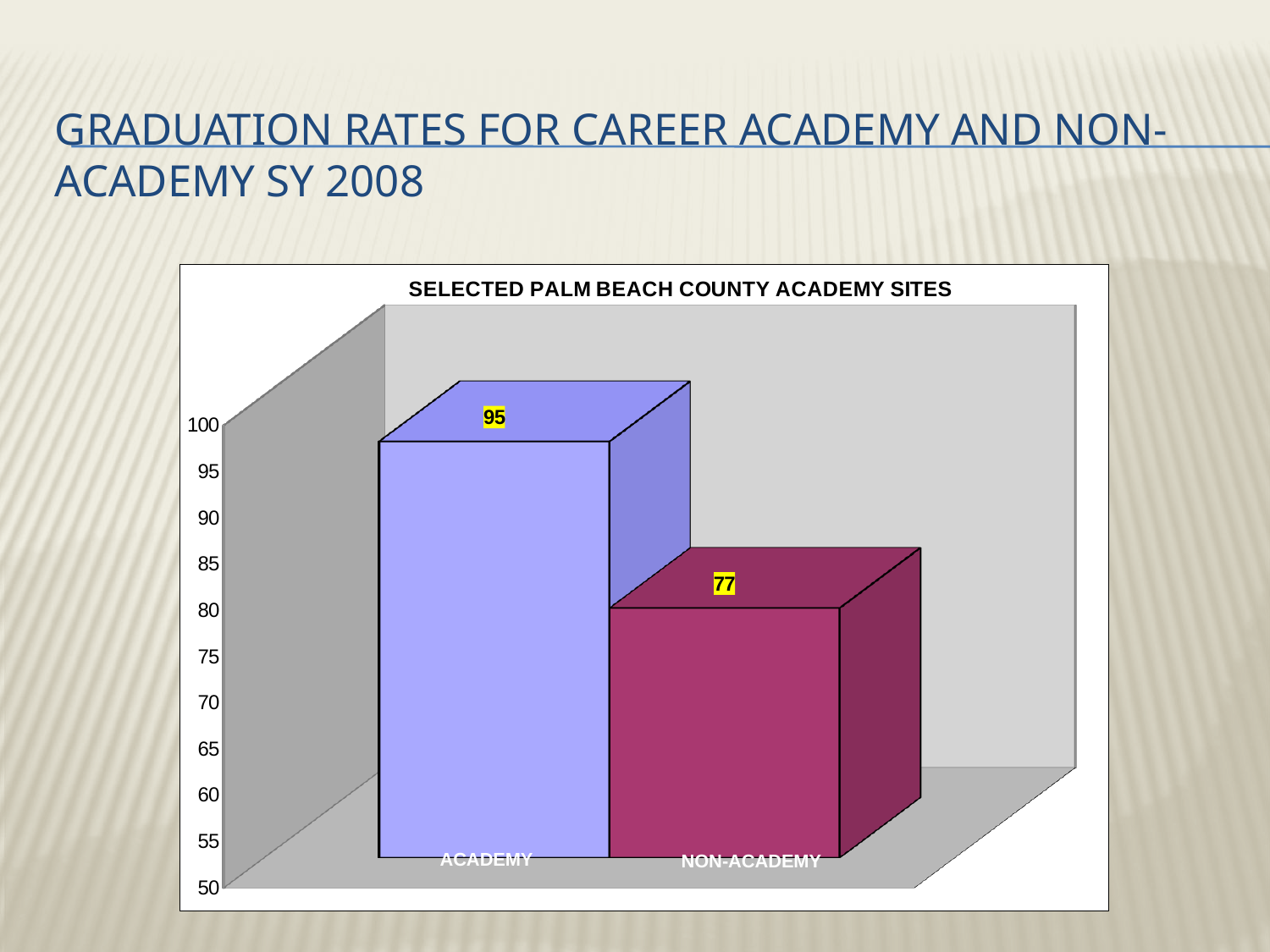
What is the difference between the ACADEMY and NON-ACADEMY values? 18 Is the value for NON-ACADEMY greater or less than 80? less Which category has the lowest value? NON-ACADEMY What is the graduation rate value shown for ACADEMY? 95 What kind of chart is shown on the slide? bar chart Which is larger, the value for ACADEMY or the value for NON-ACADEMY? ACADEMY How many categories are shown in the chart? 2 Is the value for ACADEMY greater or less than 90? greater What is the lowest value shown on the vertical axis? 50 What is the title of the chart? SELECTED PALM BEACH COUNTY ACADEMY SITES What is the graduation rate value shown for NON-ACADEMY? 77 Which category has the highest value? ACADEMY